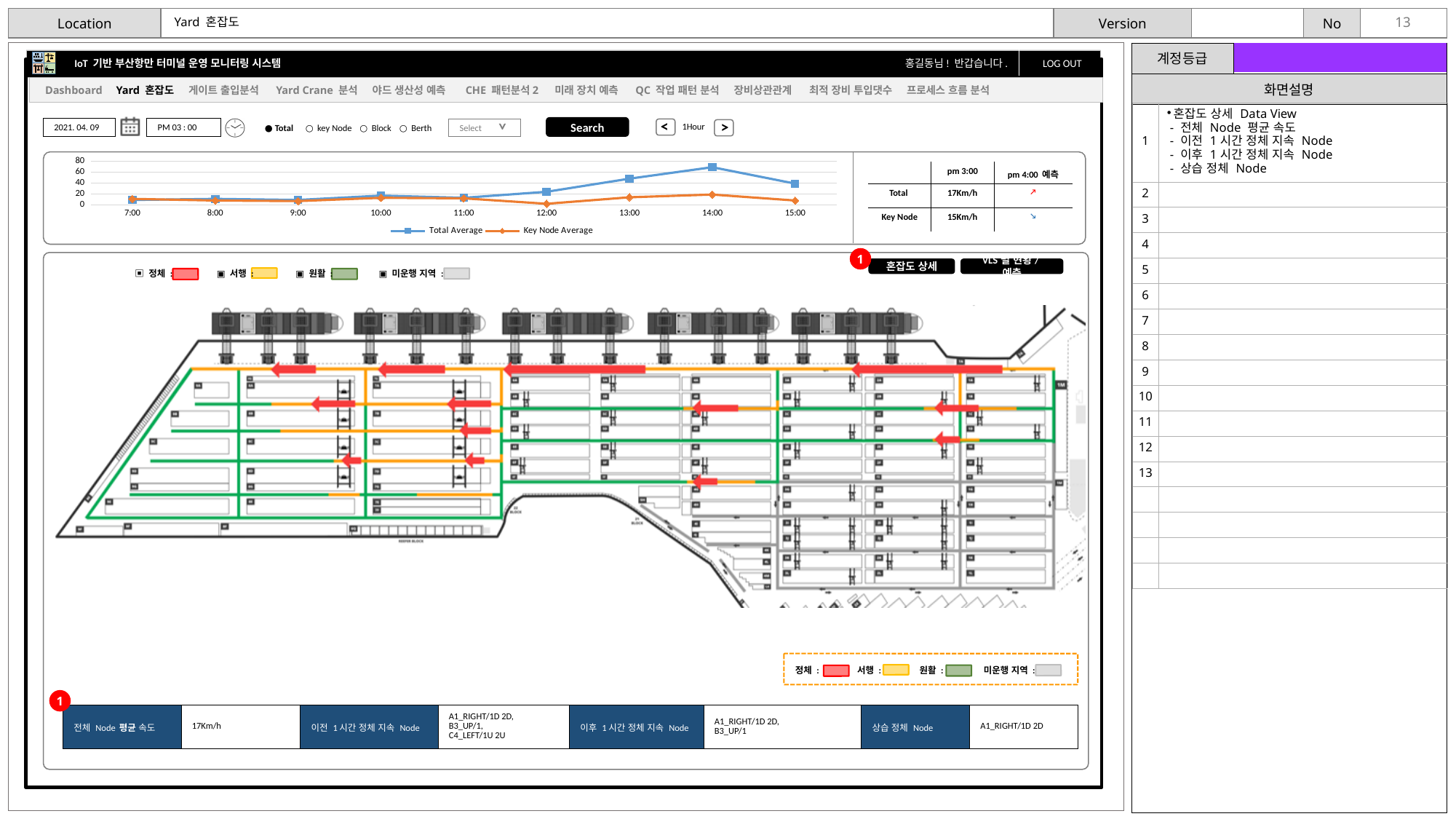
Is the Total Average value at 14:00 greater or less than 40? greater Does the Total Average series rise or fall between 14:00 and 15:00? fall Is the Key Node Average value at 12:00 greater or less than 20? less What are the two series names shown in the line chart legend? Total Average, Key Node Average At 14:00, which series has the larger value, Total Average or Key Node Average? Total Average How many series does the legend of the line chart list? 2 How many time points are plotted along the x axis of the line chart? 9 What colour is the Key Node Average line in the chart? orange At which time does the Total Average series reach its highest value? 14:00 Is the Total Average value at 8:00 greater or less than 40? less What kind of chart is shown at the top of the dashboard? line chart Does the Total Average series rise or fall between 12:00 and 14:00? rise